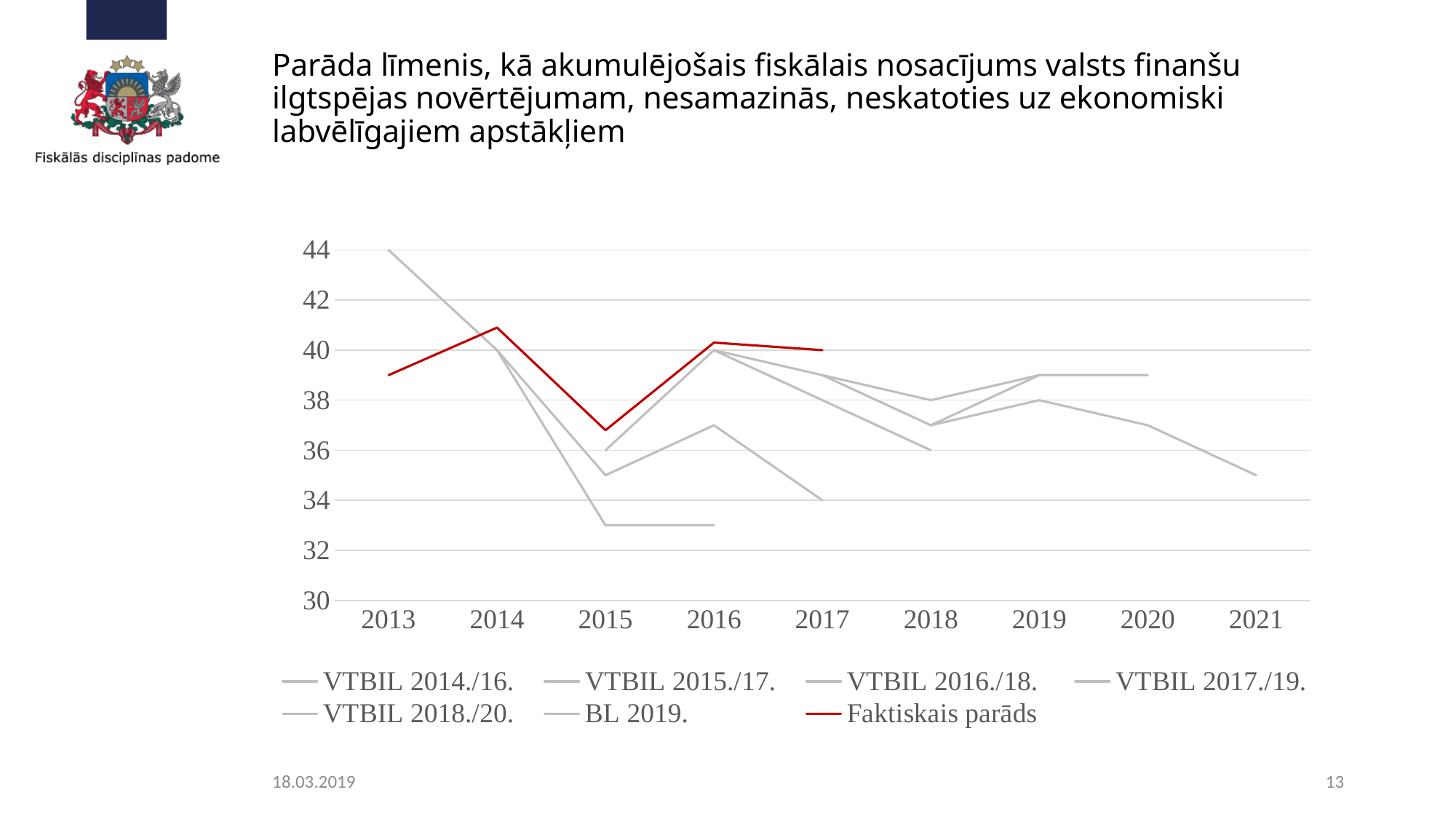
Is the value of Faktiskais parāds in 2015 greater or less than 38? less Is the value of Faktiskais parāds in 2017 greater or less than 38? greater Is the value of Faktiskais parāds in 2014 greater or less than 40? greater What is the last year shown on the x axis? 2021 Which series is drawn in red? Faktiskais parāds In which year does the Faktiskais parāds line reach its highest value? 2014 Does the Faktiskais parāds line rise or fall from 2014 to 2015? fall In which year does the Faktiskais parāds line reach its lowest value? 2015 How many series does the legend list? 7 How many years are shown on the x axis? 9 What kind of chart is shown on the slide? line chart